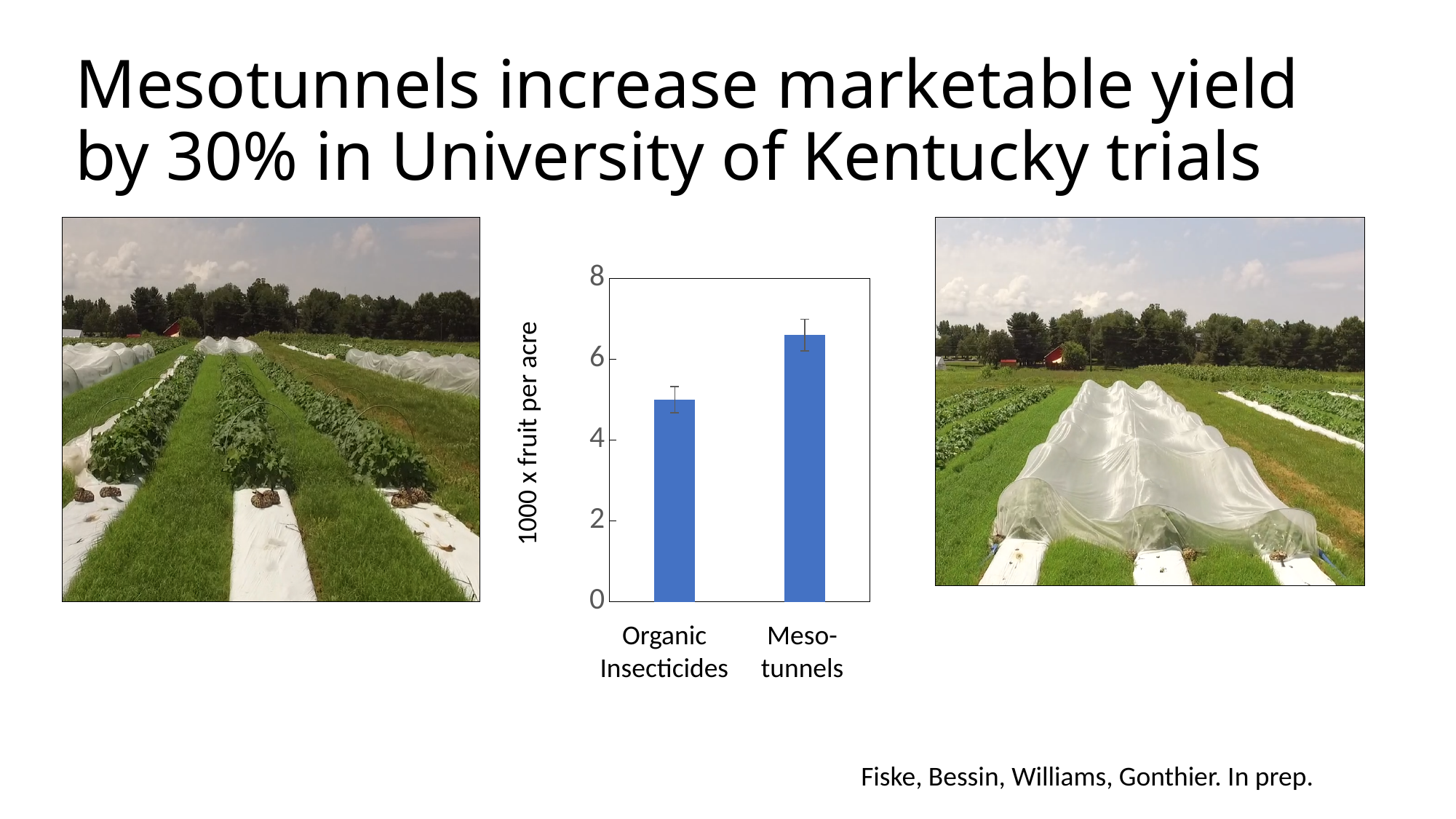
What kind of chart is shown on the slide? bar chart Which category has the higher value in the bar chart? Meso-tunnels Which category has the lower value in the bar chart? Organic Insecticides Is the value for Meso-tunnels greater or less than 6? greater Is the value for Meso-tunnels greater or less than 8? less What is the highest tick value shown on the vertical axis of the bar chart? 8 How many categories are plotted in the bar chart? 2 Which is larger, the value for Organic Insecticides or the value for Meso-tunnels? Meso-tunnels Is the value for Organic Insecticides greater or less than 6? less What is the label on the vertical axis of the bar chart? 1000 x fruit per acre